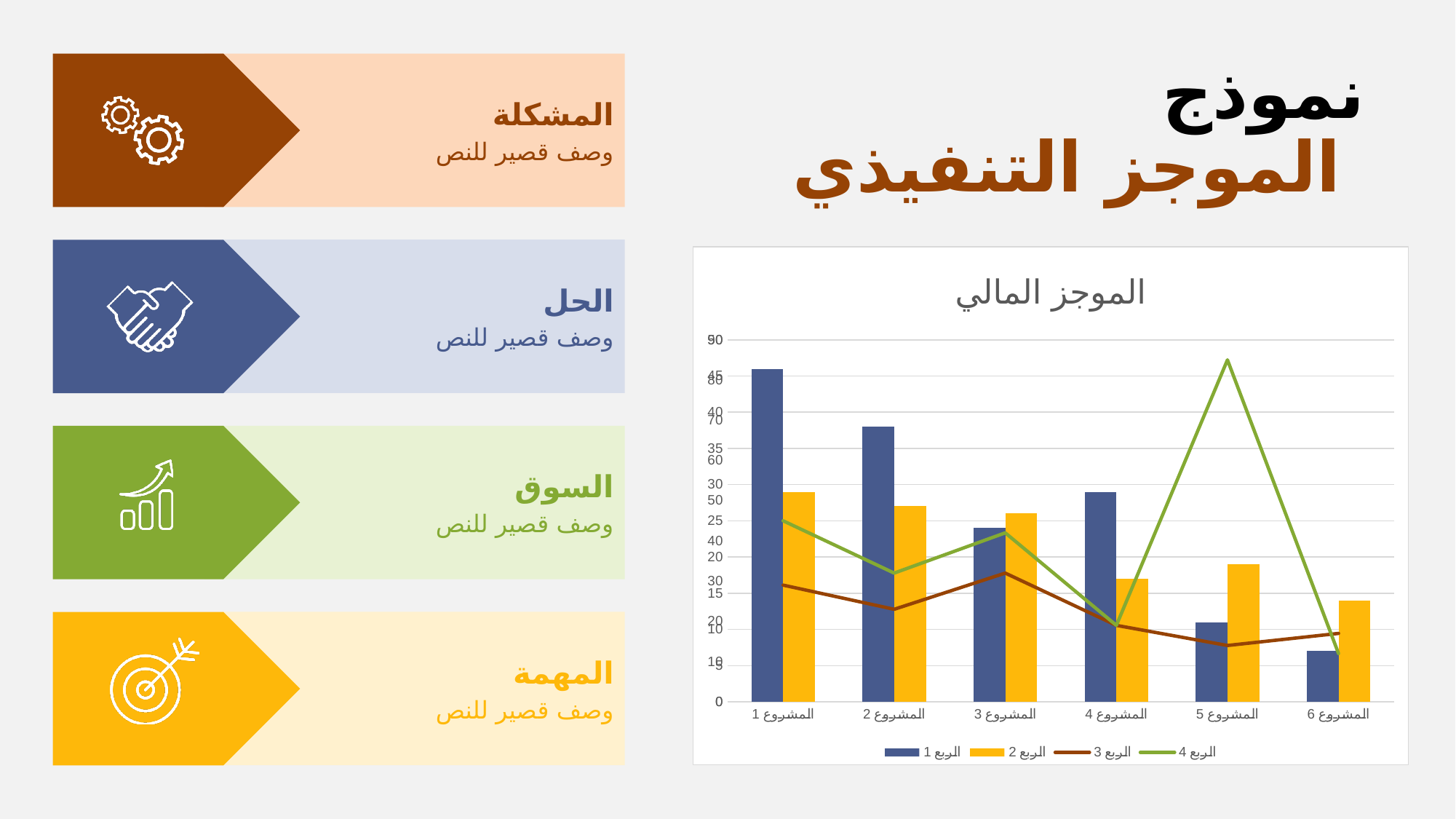
Which series in the chart are drawn as lines rather than bars? الربع 3 and الربع 4 For المشروع 6, which is larger: الربع 1 or الربع 2? الربع 2 How many project categories are shown on the x axis of the chart? 6 For which project is the الربع 1 bar the highest? المشروع 1 For which project is the الربع 1 bar the lowest? المشروع 6 For which project does the الربع 4 line reach its highest point? المشروع 5 What is the title of the chart on the slide? الموجز المالي For المشروع 1, which is larger: الربع 1 or الربع 2? الربع 1 What kind of chart is shown on the slide? A combination chart with bars and lines How many series does the chart legend list? 4 For المشروع 5, which is larger: الربع 1 or الربع 2? الربع 2 For which project is the الربع 2 bar the highest? المشروع 1